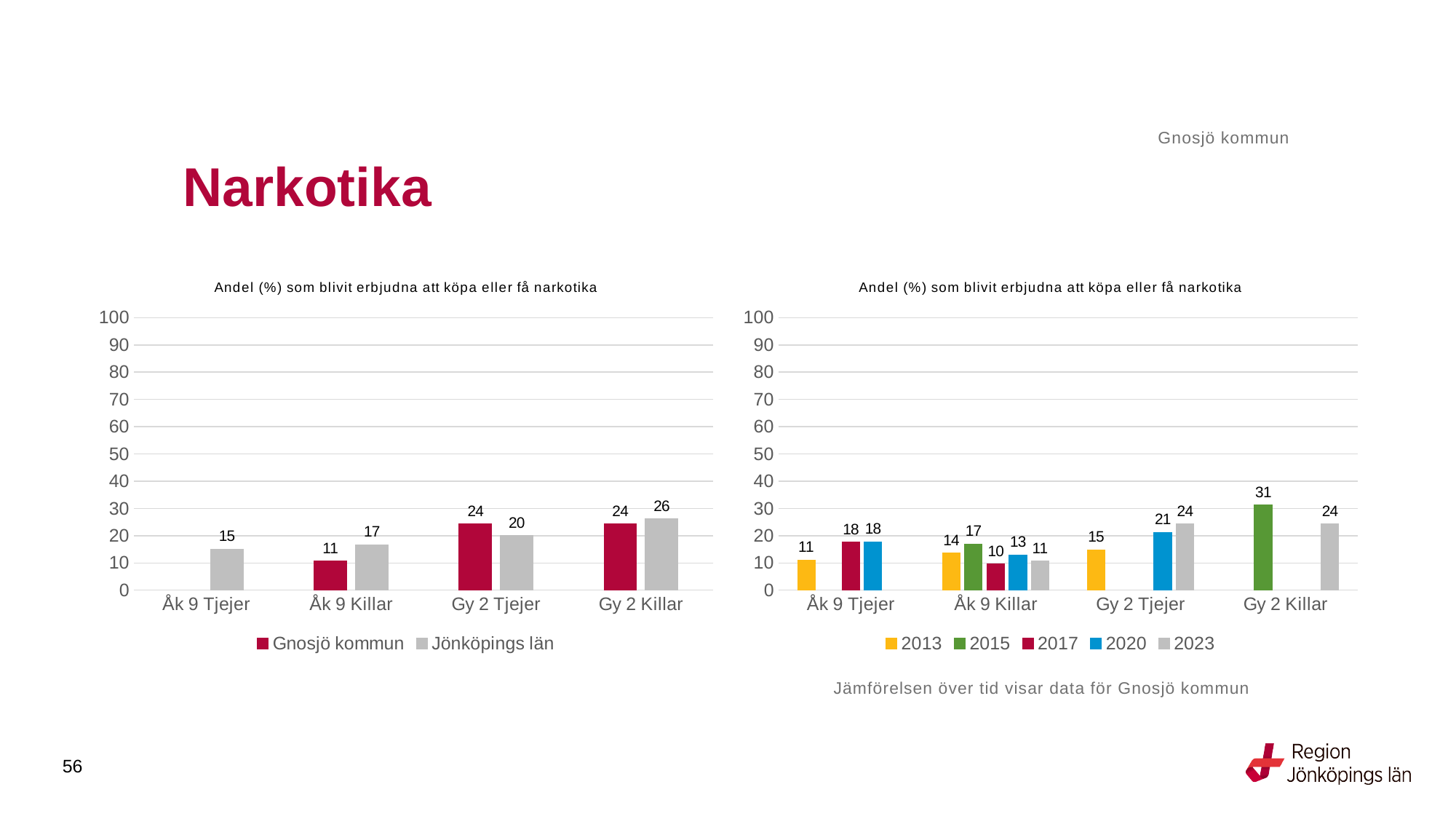
How many series does the legend of the right chart list? 5 In the left chart, what is the value for Jönköpings län for Gy 2 Killar? 26 In the left chart, what is the difference between Jönköpings län and Gnosjö kommun for Åk 9 Killar? 6 In the left chart, which category has the highest value for Jönköpings län? Gy 2 Killar What kind of chart is the right chart? Bar chart In the right chart, which year has the lowest value for Åk 9 Killar? 2017 In the right chart, what is the value for 2023 for Åk 9 Killar? 11 How many series does the legend of the left chart list? 2 In the left chart, what is the value for Gnosjö kommun for Åk 9 Killar? 11 In the right chart, what is the difference between 2023 and 2013 for Gy 2 Tjejer? 9 In the right chart, what is the value for 2015 for Gy 2 Killar? 31 In the left chart, which is larger for Gy 2 Tjejer: Gnosjö kommun or Jönköpings län? Gnosjö kommun